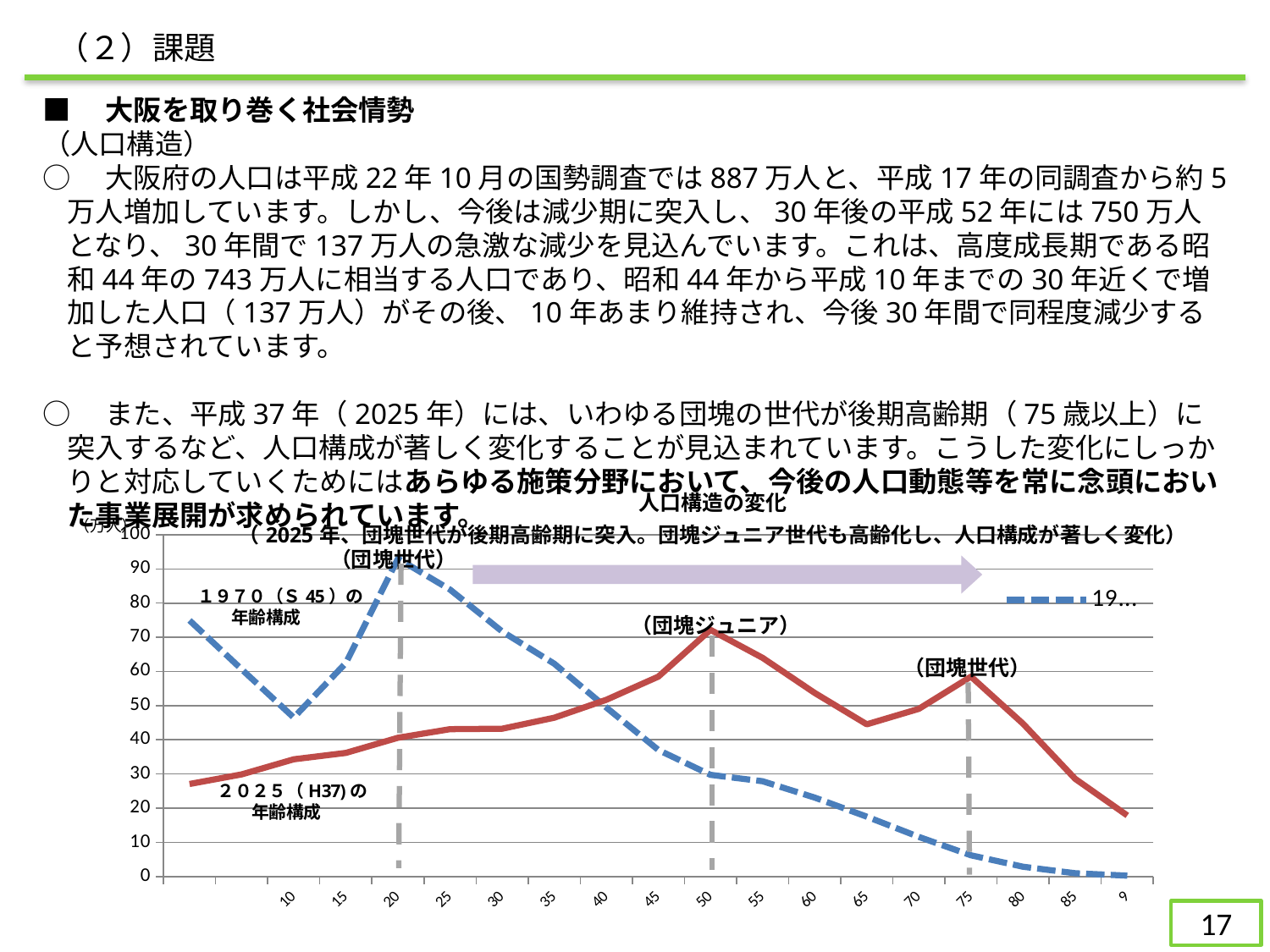
What kind of chart is shown on the slide? line chart Is the value of the 2025 (H37) age composition line at age 50 greater or less than 60? greater Does the 1970 (S45) age composition line rise or fall from age 20 to age 90? fall At which age on the x axis does the 2025 (H37) age composition line reach its highest value? 50 At age 20, which line has the higher value, the 1970 (S45) age composition or the 2025 (H37) age composition? 1970 (S45) age composition Which line is drawn as a dashed line, the 1970 (S45) age composition or the 2025 (H37) age composition? 1970 (S45) age composition Is the value of the 1970 (S45) age composition line at age 20 greater or less than 80? greater At which age on the x axis does the 1970 (S45) age composition line reach its highest value? 20 Is the value of the 1970 (S45) age composition line at age 90 greater or less than 10? less How many lines are plotted on the chart? 2 What is the title of the chart? 人口構造の変化